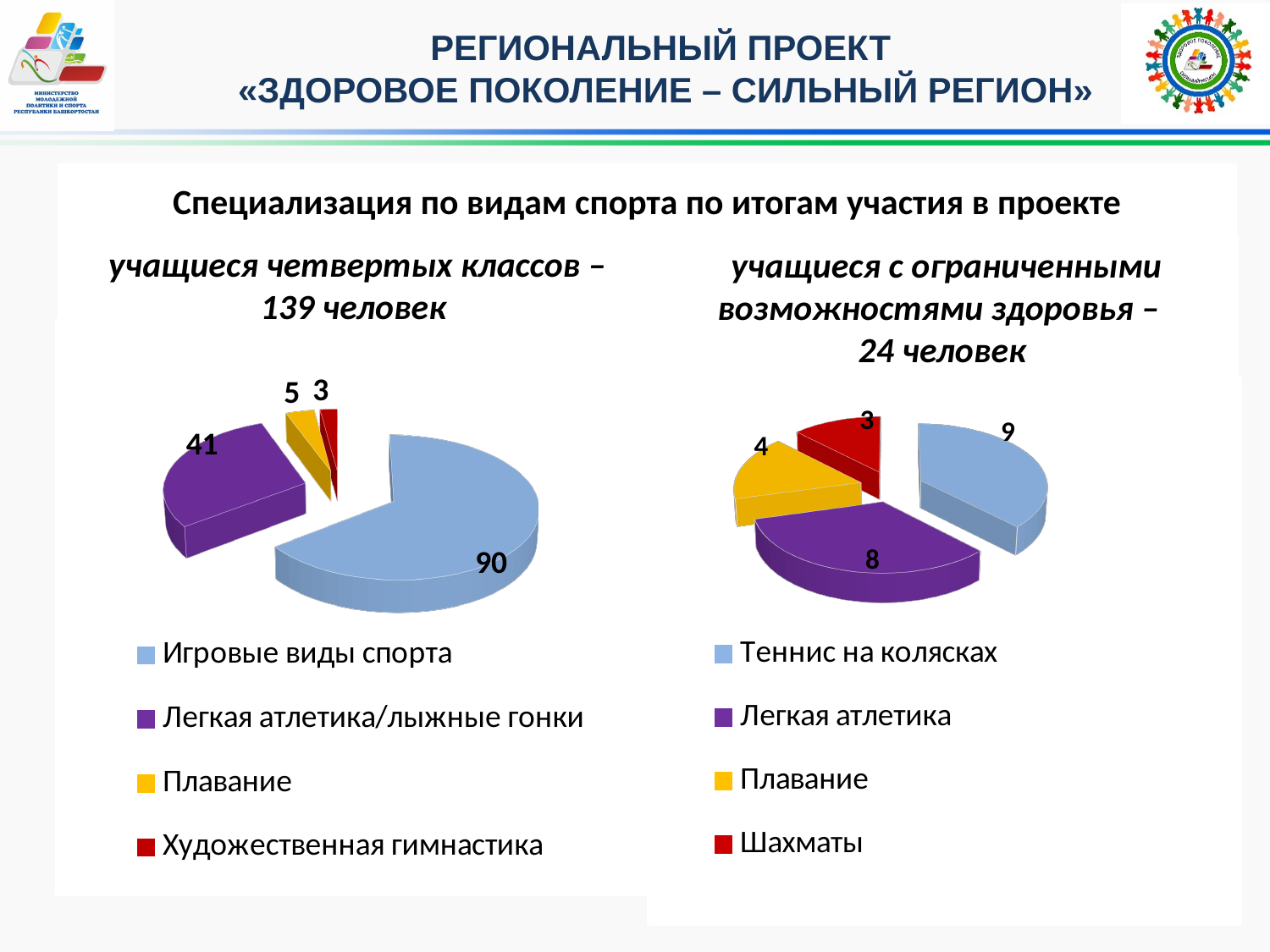
In the left pie chart (учащиеся четвертых классов), what is the value for Игровые виды спорта? 90 In the right pie chart (учащиеся с ограниченными возможностями здоровья), what share of the total does Теннис на колясках represent? 37.5% What type of chart is used on the left for учащиеся четвертых классов? Pie chart In the left pie chart (учащиеся четвертых классов), which is larger: Плавание or Художественная гимнастика? Плавание In the right pie chart (учащиеся с ограниченными возможностями здоровья), what is the difference between Плавание and Шахматы? 1 In the right pie chart (учащиеся с ограниченными возможностями здоровья), which category has the largest value? Теннис на колясках In the right pie chart (учащиеся с ограниченными возможностями здоровья), what is the value for Теннис на колясках? 9 How many categories does the right pie chart (учащиеся с ограниченными возможностями здоровья) show? 4 In the right pie chart (учащиеся с ограниченными возможностями здоровья), what is the value for Шахматы? 3 In the left pie chart (учащиеся четвертых классов), which category has the smallest value? Художественная гимнастика In the left pie chart (учащиеся четвертых классов), what is the value for Легкая атлетика/лыжные гонки? 41 In the left pie chart (учащиеся четвертых классов), what is the difference between Игровые виды спорта and Легкая атлетика/лыжные гонки? 49